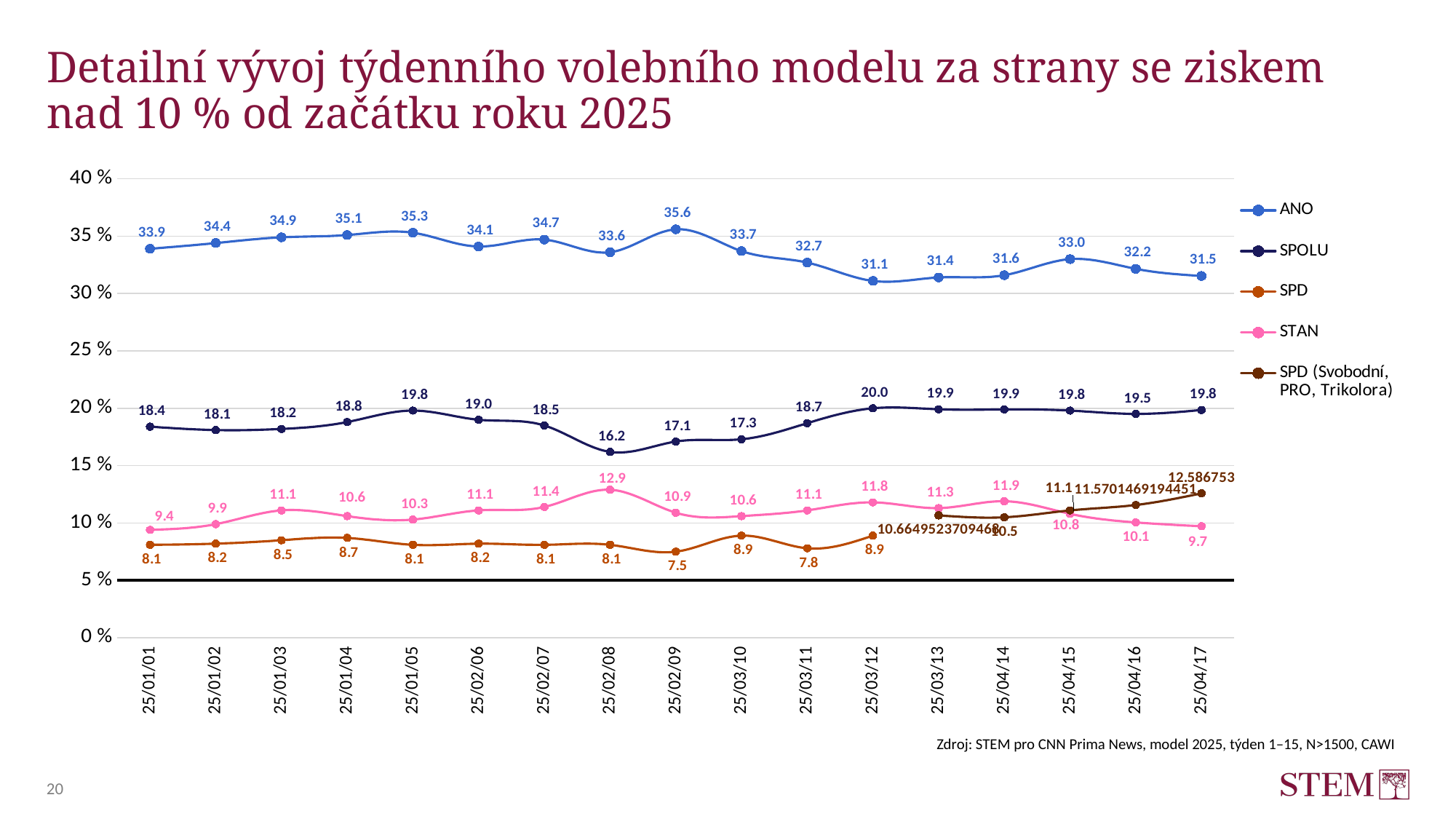
Which is larger: the STAN value at 25/02/08 or at 25/03/12? 25/02/08 How many series does the legend list? 5 What is the difference between the ANO and SPOLU values at 25/04/17? 11.7 What is the highest value shown for STAN? 12.9 Which series is drawn in pink? STAN At which date does SPD have its lowest value? 25/02/09 What kind of chart is shown on the slide? line chart How many dates are shown on the x axis? 17 At which date does ANO reach its highest value? 25/02/09 What is the value for SPOLU at 25/02/08? 16.2 Is the value for ANO at 25/03/12 greater or less than 30 %? greater What is the value for ANO at 25/02/09? 35.6